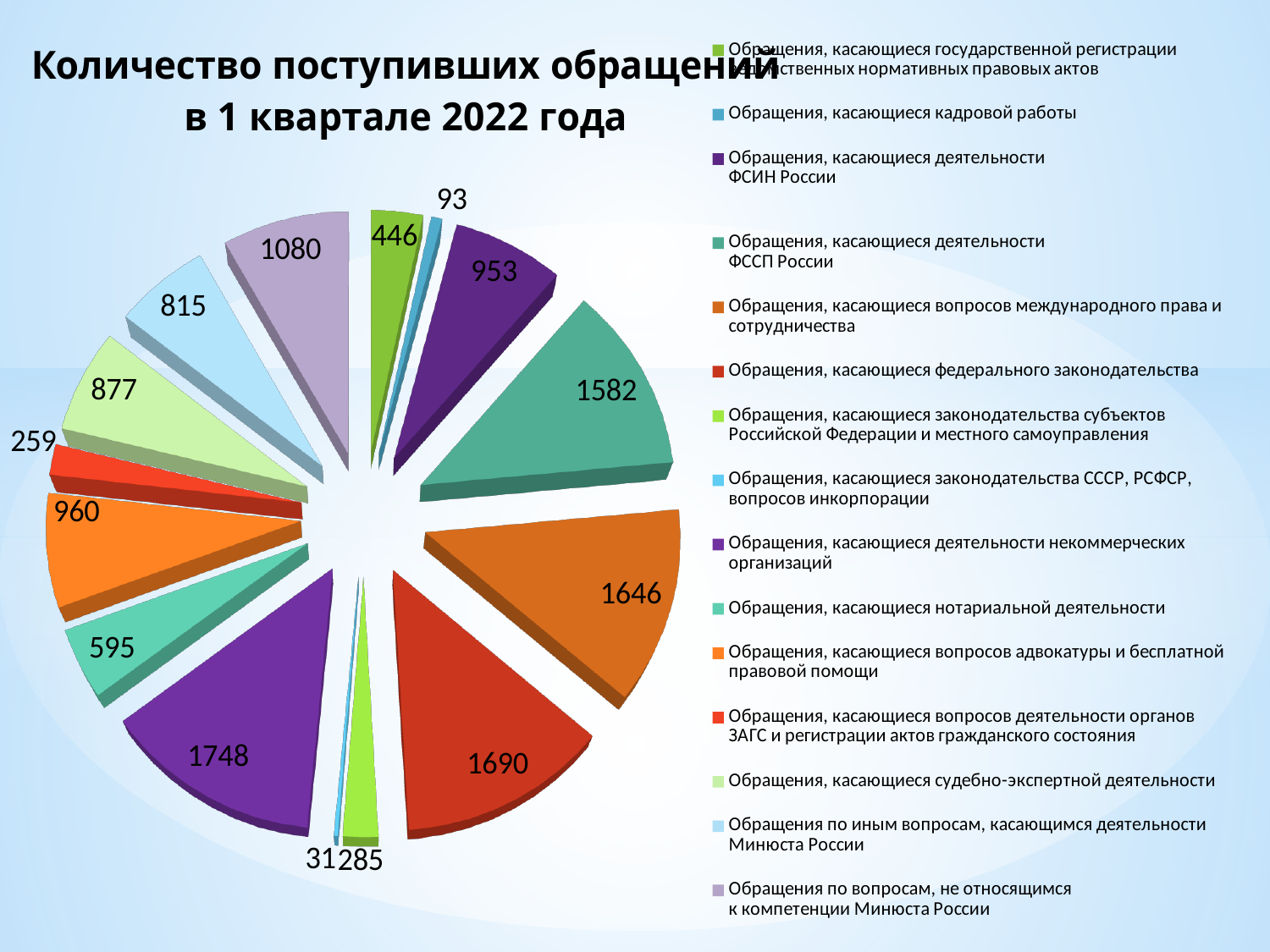
What is the title of the chart? Количество поступивших обращений в 1 квартале 2022 года What is the difference between the values for обращения по иным вопросам, касающимся деятельности Минюста России (815) and обращения, касающиеся судебно-экспертной деятельности (877)? 62 Which category has the largest value? Обращения, касающиеся деятельности некоммерческих организаций What is the difference between the values for обращения, касающиеся деятельности некоммерческих организаций (1748) and обращения, касающиеся федерального законодательства (1690)? 58 Which category has the smallest value? Обращения, касающиеся законодательства СССР, РСФСР, вопросов инкорпорации What is the value for обращения, касающиеся деятельности ФССП России? 1582 What is the value for обращения, касающиеся деятельности некоммерческих организаций? 1748 Which is larger: the value for обращения, касающиеся вопросов международного права и сотрудничества or the value for обращения, касающиеся деятельности ФССП России? Обращения, касающиеся вопросов международного права и сотрудничества What is the value for обращения, касающиеся кадровой работы? 93 How many categories does the legend list? 15 What type of chart is shown on the slide? pie chart What is the value for обращения по вопросам, не относящимся к компетенции Минюста России? 1080